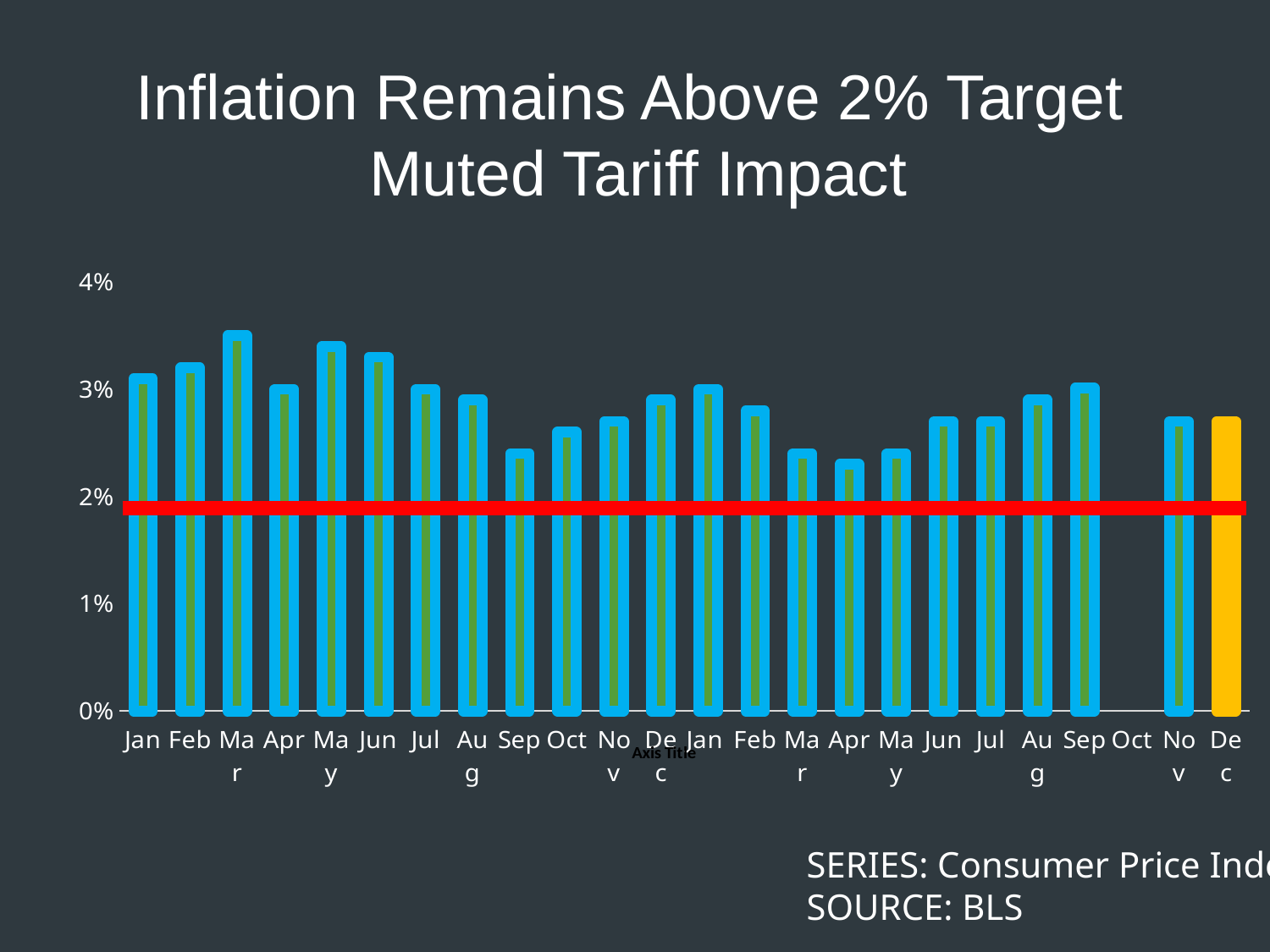
Is the value for the first Mar (third bar from the left) greater or less than 3%? greater How many month categories are labelled on the x axis? 24 Is the value for the first Sep (ninth bar from the left) greater or less than 3%? less Do the values rise or fall from the first Mar to the first Sep along the x axis? fall Which month has the highest bar in the chart? Mar (the first Mar, third bar from the left) What is the title of the chart on the slide? Inflation Remains Above 2% Target Muted Tariff Impact Which is larger, the value for the first Mar (third bar from the left) or the value for the second Apr (the Apr bar in the right half)? the first Mar Is the value for the first Jun (sixth bar from the left) greater or less than 3%? greater What kind of chart is shown on the slide? bar chart What level does the horizontal red line across the chart mark? 2%